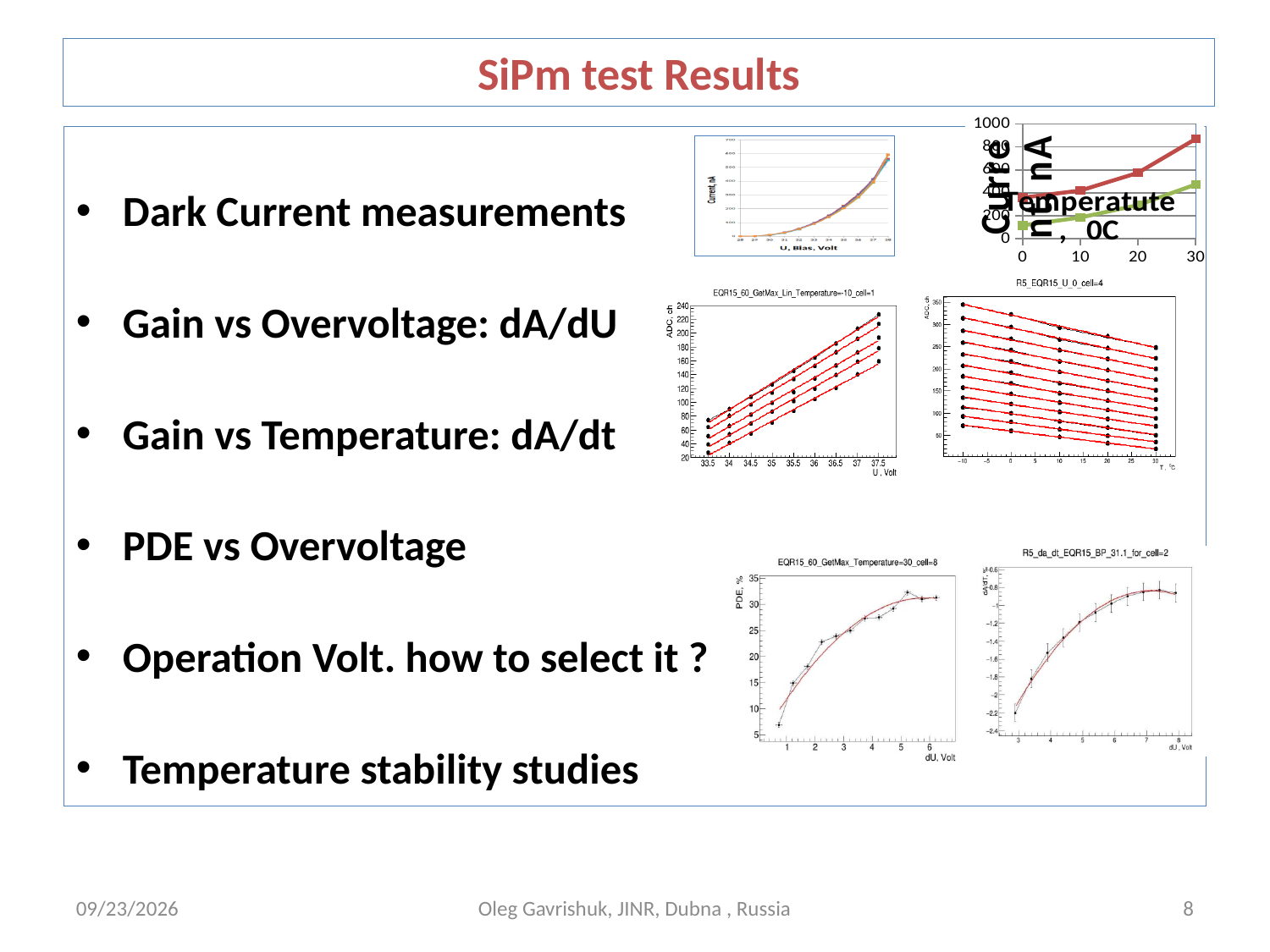
In the top-right chart of Current, nA versus Temperature, 0C, is the value of the red series at 30 greater or less than 600? greater In the top-right chart of Current, nA versus Temperature, 0C, does the red series rise or fall as temperature increases? rise In the top-right chart of Current, nA versus Temperature, 0C, which series has the larger value at 30: the red series or the green series? the red series In the top-right chart of Current, nA versus Temperature, 0C, what kind of chart is it? line chart In the top-right chart of Current, nA versus Temperature, 0C, is the value of the green series at 30 greater or less than 600? less In the top-right chart of Current, nA versus Temperature, 0C, how many data points does the red series have? 4 In the chart titled EQR15_60_GetMax_Lin_Temperature=-10_cell=1 (ADC, ch versus U, Volt), do the values rise or fall as U increases? rise In the chart titled R5_EQR15_U_0_cell=4 (ADC, ch versus T, °C), do the values rise or fall as temperature increases? fall In the chart titled EQR15_60_GetMax_Temperature=30_cell=8 (PDE, % versus dU, Volt), is the PDE value at dU = 1 greater or less than 10? less In the top-right chart of Current, nA versus Temperature, 0C, what is the highest value shown on the vertical axis? 1000